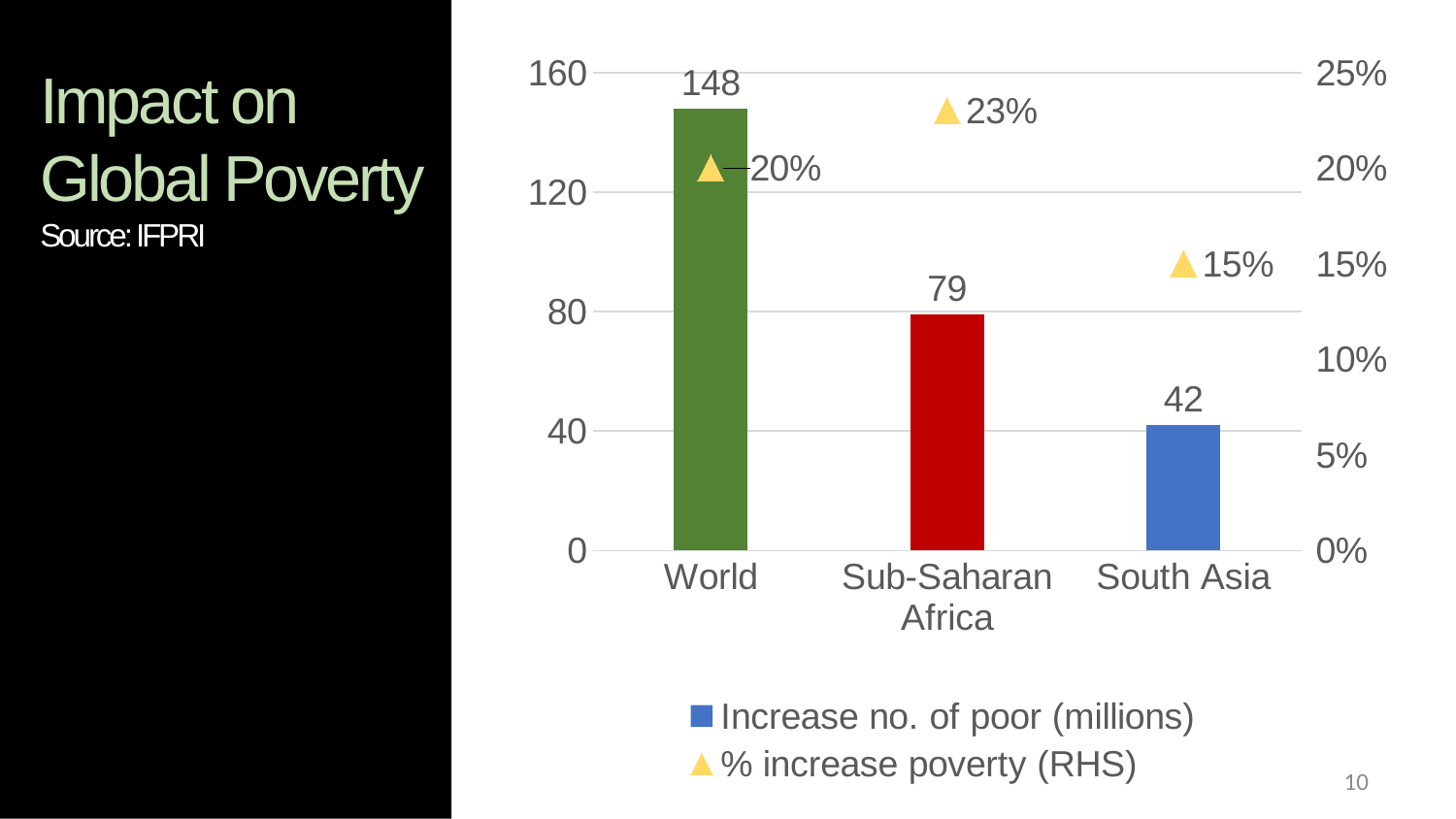
Which has a larger % increase in poverty, the World or South Asia? World How many categories are shown on the x axis? 3 What is the difference in the increase in the number of poor (millions) between Sub-Saharan Africa and South Asia? 37 What is the % increase in poverty for Sub-Saharan Africa? 23% What is the % increase in poverty for South Asia? 15% What is the increase in the number of poor (millions) for South Asia? 42 How many series does the legend list? 2 Which category has the lowest increase in the number of poor (millions)? South Asia What is the source cited for the chart? IFPRI What is the increase in the number of poor (millions) for Sub-Saharan Africa? 79 What is the increase in the number of poor (millions) for the World? 148 Which region has the highest % increase in poverty? Sub-Saharan Africa